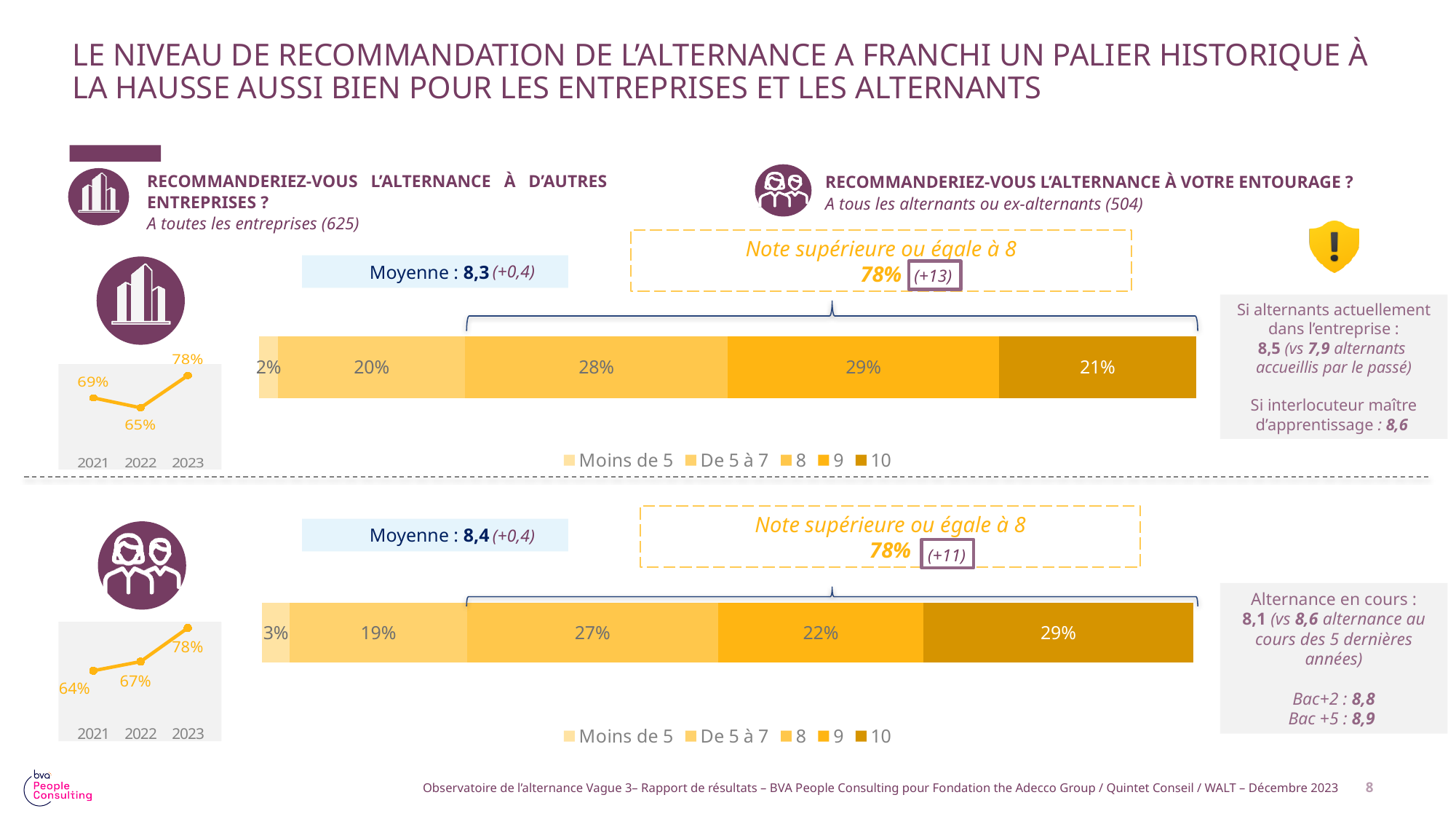
In the top stacked bar chart (recommendation by entreprises), what share gave a score of 'Moins de 5'? 2% How many series does the legend of the bottom stacked bar chart list? 5 In the top stacked bar chart (recommendation by entreprises), what share gave a score of 9? 29% In the top stacked bar chart (recommendation by entreprises), which score category has the largest share? 9 In the bottom stacked bar chart (recommendation by alternants), what is the difference between the share for score 8 and the share for score 9? 5% What type of chart is used to show the distribution of scores for the entreprises? Stacked bar chart In the bottom stacked bar chart (recommendation by alternants), which score category has the smallest share? Moins de 5 In the small line chart at the bottom left (alternants), what is the value for 2021? 64% In the top stacked bar chart (recommendation by entreprises), which is larger: the share for score 10 or the share for 'De 5 à 7'? 10 In the small line chart at the bottom left (alternants), do the values rise or fall from 2021 to 2023? Rise In the small line chart at the top left (entreprises), what is the value for 2022? 65% In the bottom stacked bar chart (recommendation by alternants), what share gave a score of 10? 29%